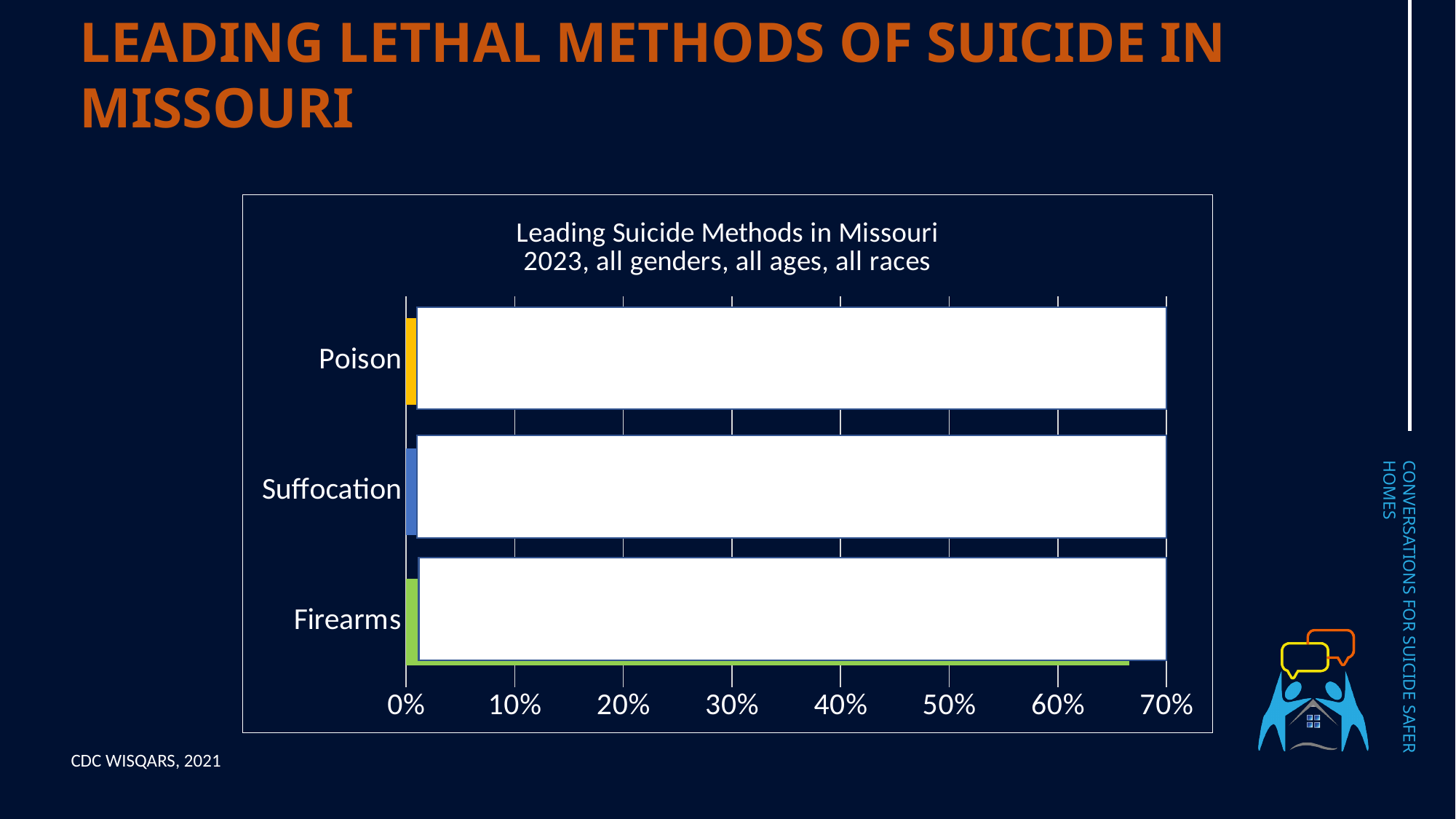
What is the highest value shown on the horizontal axis of the chart? 70% Which category is listed at the top of the chart? Poison What colour is the bar for Firearms? green How many categories (suicide methods) are plotted in the chart? 3 What is the title of the chart? Leading Suicide Methods in Missouri 2023, all genders, all ages, all races What kind of chart is shown on the slide? bar chart Is the value for Firearms greater or less than 60%? greater Is the value for Firearms greater or less than 70%? less Which category is listed at the bottom of the chart? Firearms Is the value for Firearms greater or less than 50%? greater